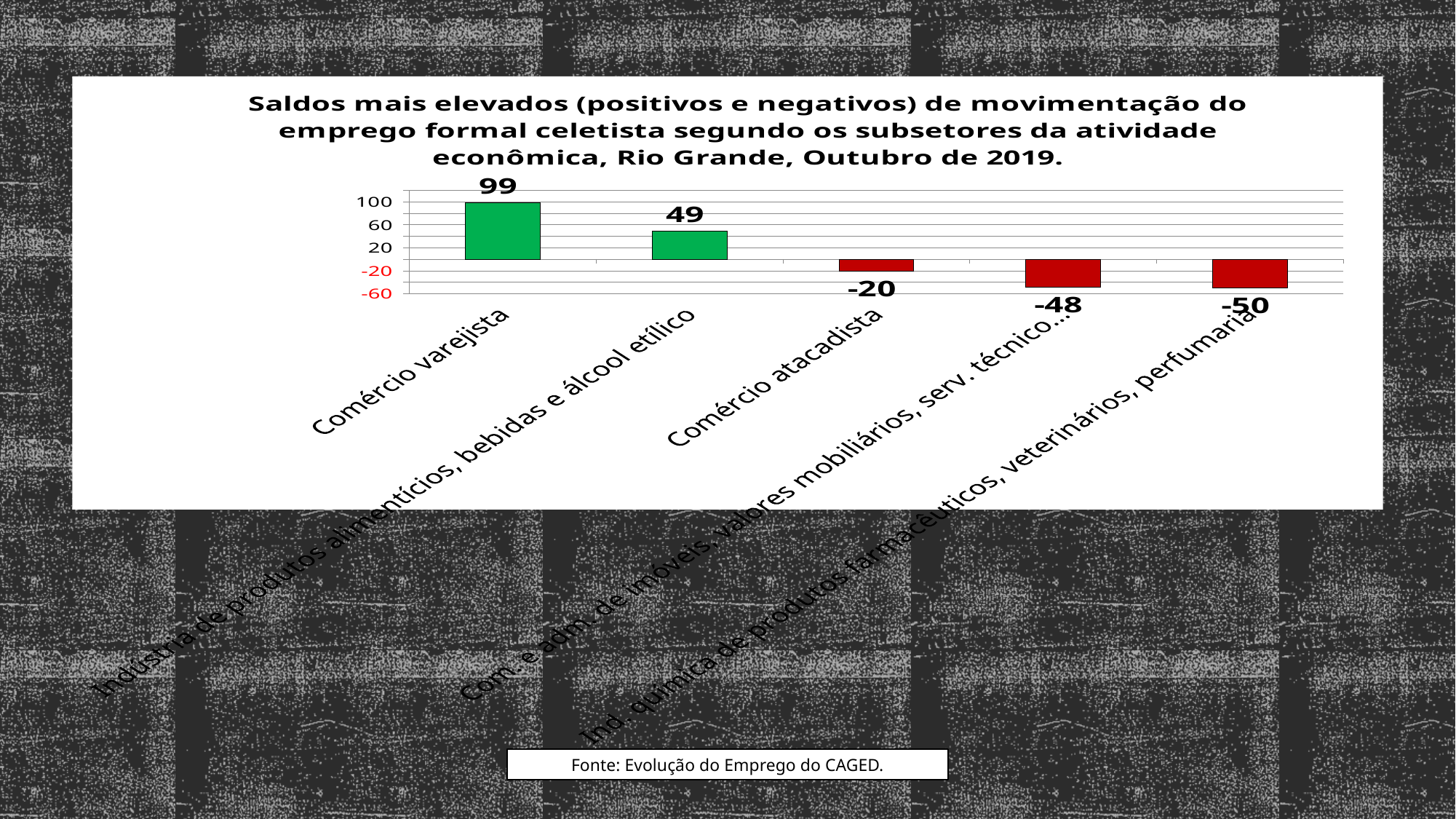
What kind of chart is shown on the slide? Bar chart What is the value for Ind. química de produtos farmacêuticos, veterinários, perfumaria? -50 What is the difference between the values for Comércio varejista and Indústria de produtos alimentícios, bebidas e álcool etílico? 50 Which category has the lowest value? Ind. química de produtos farmacêuticos, veterinários, perfumaria Which category has the highest value? Comércio varejista What is the value for Indústria de produtos alimentícios, bebidas e álcool etílico? 49 How many categories have negative values? 3 How many categories are shown in the chart? 5 What is the value for Comércio atacadista? -20 Which is larger, the value for Comércio varejista or the value for Comércio atacadista? Comércio varejista What colour are the bars with negative values? Red What is the value for Comércio varejista? 99